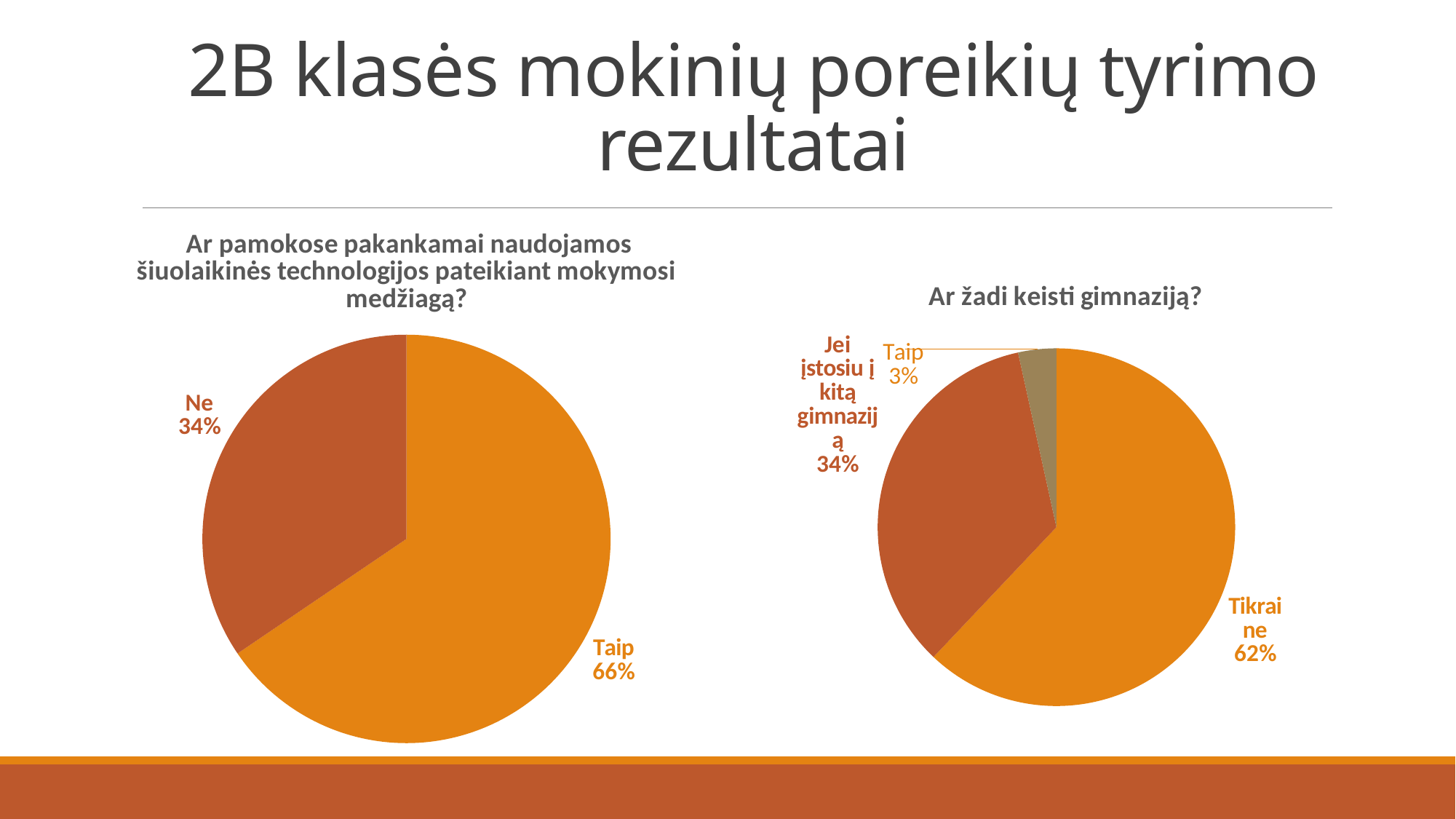
In the right chart ("Ar žadi keisti gimnaziją?"), which is larger: "Tikrai ne" or "Jei įstosiu į kitą gimnaziją"? Tikrai ne In the left chart ("Ar pamokose pakankamai naudojamos šiuolaikinės technologijos pateikiant mokymosi medžiagą?"), what share of the pie is "Taip"? 66% In the right chart ("Ar žadi keisti gimnaziją?"), which slice is the smallest? Taip In the left chart ("Ar pamokose pakankamai naudojamos šiuolaikinės technologijos pateikiant mokymosi medžiagą?"), how many slices does the pie have? 2 In the right chart ("Ar žadi keisti gimnaziją?"), what share of the pie is "Jei įstosiu į kitą gimnaziją"? 34% In the right chart ("Ar žadi keisti gimnaziją?"), what share of the pie is "Taip"? 3% In the left chart ("Ar pamokose pakankamai naudojamos šiuolaikinės technologijos pateikiant mokymosi medžiagą?"), which slice is the largest? Taip In the right chart ("Ar žadi keisti gimnaziją?"), how many slices does the pie have? 3 In the left chart ("Ar pamokose pakankamai naudojamos šiuolaikinės technologijos pateikiant mokymosi medžiagą?"), what is the difference in percentage points between "Taip" and "Ne"? 32 percentage points What type of chart is the right chart ("Ar žadi keisti gimnaziją?")? Pie chart